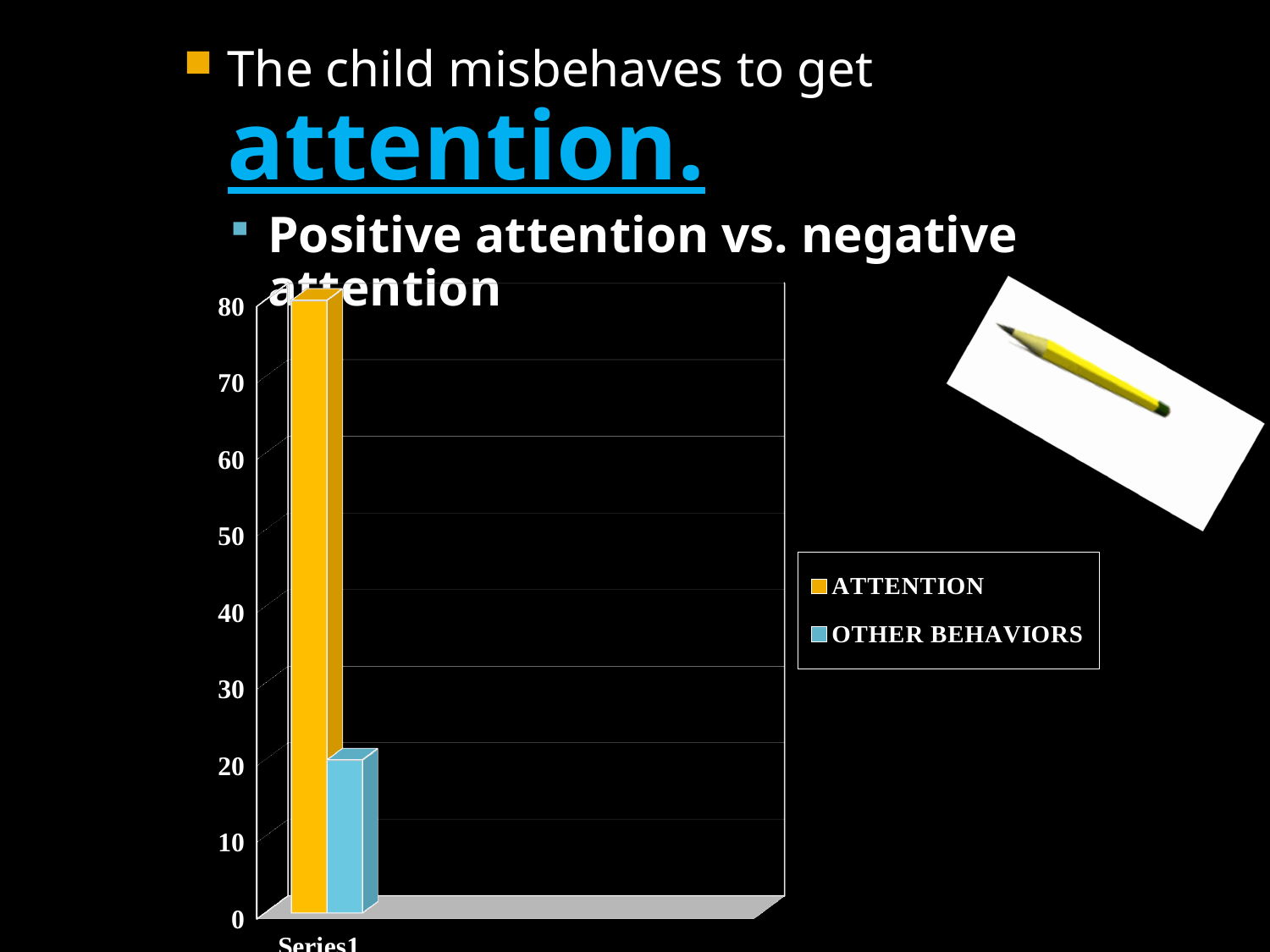
Which series has the highest bar in the chart? ATTENTION What value does the OTHER BEHAVIORS bar reach on the vertical axis? 20 How many series does the chart legend list? 2 Is the value for ATTENTION greater or less than 50? greater What is the label of the category shown on the horizontal axis? Series1 What value does the ATTENTION bar reach on the vertical axis? 80 Which series has the taller bar, ATTENTION or OTHER BEHAVIORS? ATTENTION What kind of chart is shown on the slide? bar chart What colour represents the ATTENTION series in the legend? yellow Is the value for OTHER BEHAVIORS greater or less than 10? greater Is the value for OTHER BEHAVIORS greater or less than 30? less Which series has the lowest bar in the chart? OTHER BEHAVIORS